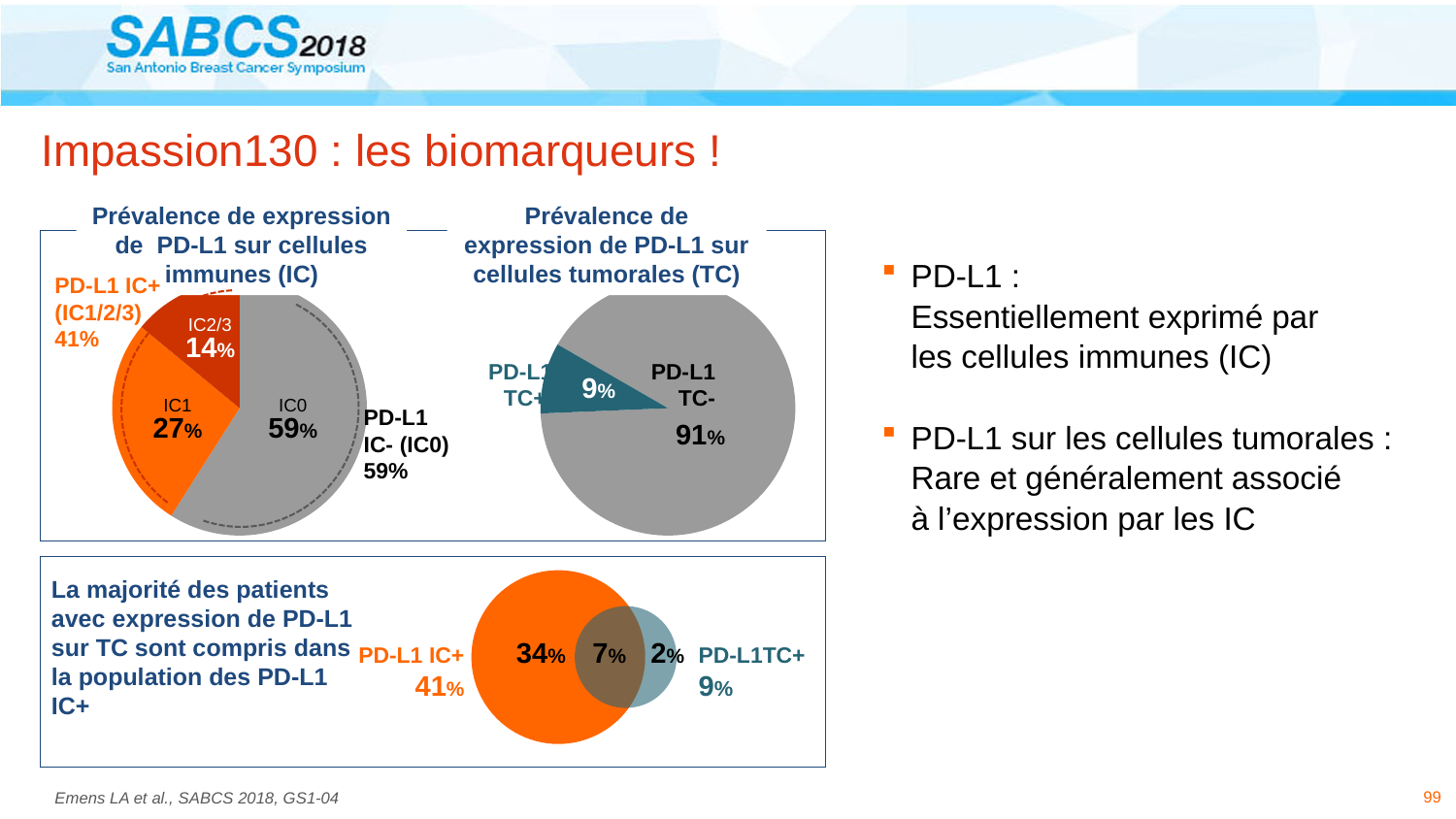
In the pie chart on tumor cells (TC), what share of patients are PD-L1 TC+? 9% In the pie chart on immune cells (IC), what share of patients are IC0? 59% In the pie chart on tumor cells (TC), what share of patients are PD-L1 TC-? 91% In the Venn diagram at the bottom, what percentage is in the overlap between PD-L1 IC+ and PD-L1 TC+? 7% What kind of chart is used to show the prevalence of PD-L1 expression on tumor cells (TC)? Pie chart In the pie chart on immune cells (IC), what is the difference between the IC1 and IC2/3 shares? 13% In the pie chart on tumor cells (TC), which is larger, PD-L1 TC+ or PD-L1 TC-? PD-L1 TC- In the pie chart on immune cells (IC), what share of patients are IC1? 27% In the pie chart on immune cells (IC), how many slices are there? 3 In the pie chart on immune cells (IC), what share of patients are IC2/3? 14% In the pie chart on immune cells (IC), which category is the largest? IC0 In the pie chart on immune cells (IC), which category is the smallest? IC2/3